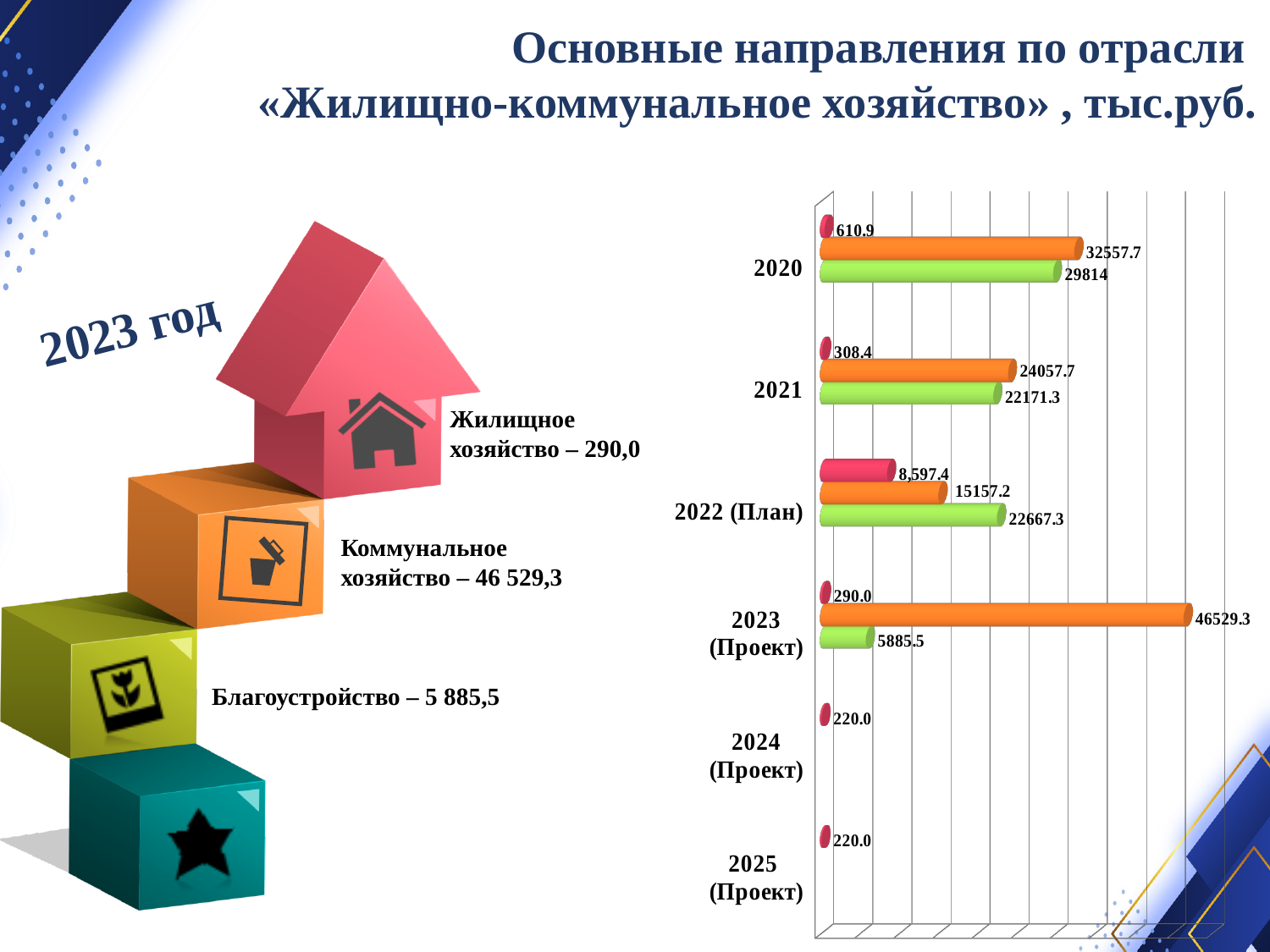
What is the value of the red bar for 2022 (План)? 8,597.4 What is the value of the green bar for 2021? 22171.3 How many year categories are shown on the chart? 6 Which year has the highest red bar value? 2022 (План) Does the red bar value rise or fall from 2020 to 2021? fall Which year has the highest orange bar value? 2023 (Проект) What is the difference between the orange bar and the green bar for 2020? 2743.7 For 2022 (План), which is larger: the orange bar or the green bar? the green bar Which year has the lowest green bar value? 2023 (Проект) What kind of chart is shown on the right side of the slide? bar chart What is the value of the orange bar for 2020? 32557.7 What is the value of the red bar for 2025 (Проект)? 220.0